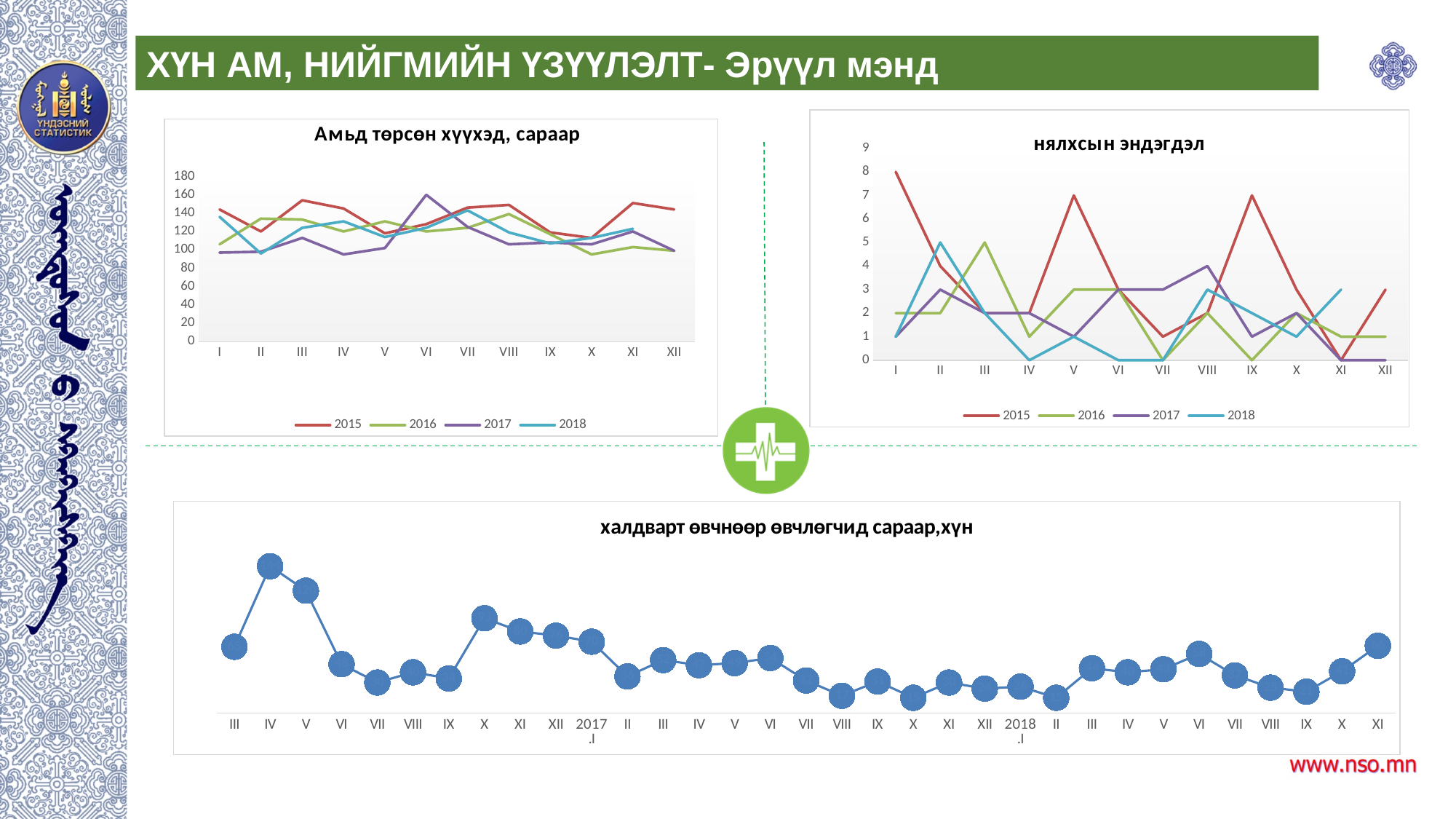
How many series does the legend of 'Амьд төрсөн хүүхэд, сараар' list? 4 How many months are shown on the x axis of 'Амьд төрсөн хүүхэд, сараар'? 12 In 'Амьд төрсөн хүүхэд, сараар', is the 2016 value for month X greater or less than 100? less In 'нялхсын эндэгдэл', what is the difference between the 2015 and 2018 values for month I? 7 What kind of chart is 'Амьд төрсөн хүүхэд, сараар'? line chart In 'нялхсын эндэгдэл', what is the 2015 value for month I? 8 In 'Амьд төрсөн хүүхэд, сараар', is the 2017 value for month VI greater or less than 140? greater Which legend entries are listed for 'нялхсын эндэгдэл'? 2015, 2016, 2017, 2018 In 'халдварт өвчнөөр өвчлөгчид сараар,хүн', how many data points are plotted? 33 In 'нялхсын эндэгдэл', what is the 2016 value for month III? 5 In 'нялхсын эндэгдэл', which is larger for month V: the 2015 value or the 2016 value? 2015 In 'нялхсын эндэгдэл', which month has the highest 2015 value? I